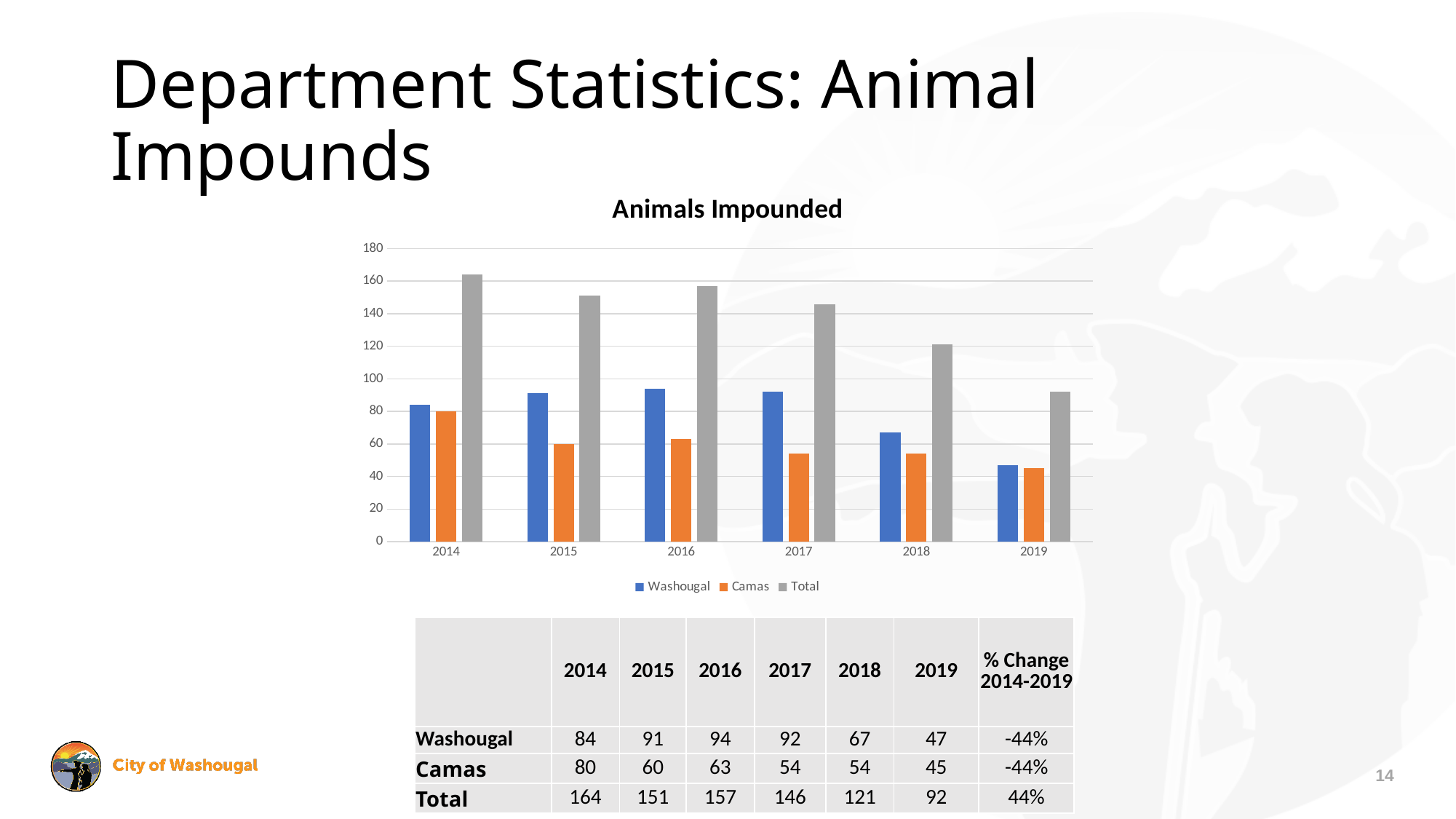
What kind of chart is shown on the slide? bar chart How many years are shown on the x axis of the chart? 6 Is the Total value for 2019 greater or less than 100? less What is the Camas value for 2019? 45 What is the Washougal value for 2016? 94 In which year is the Washougal value lowest? 2019 What is the title of the chart? Animals Impounded What is the difference between the Washougal and Camas values in 2015? 31 How many series does the chart legend list? 3 Which is larger in 2018, the Washougal value or the Camas value? Washougal What is the Total value for 2014? 164 In which year is the Total value highest? 2014